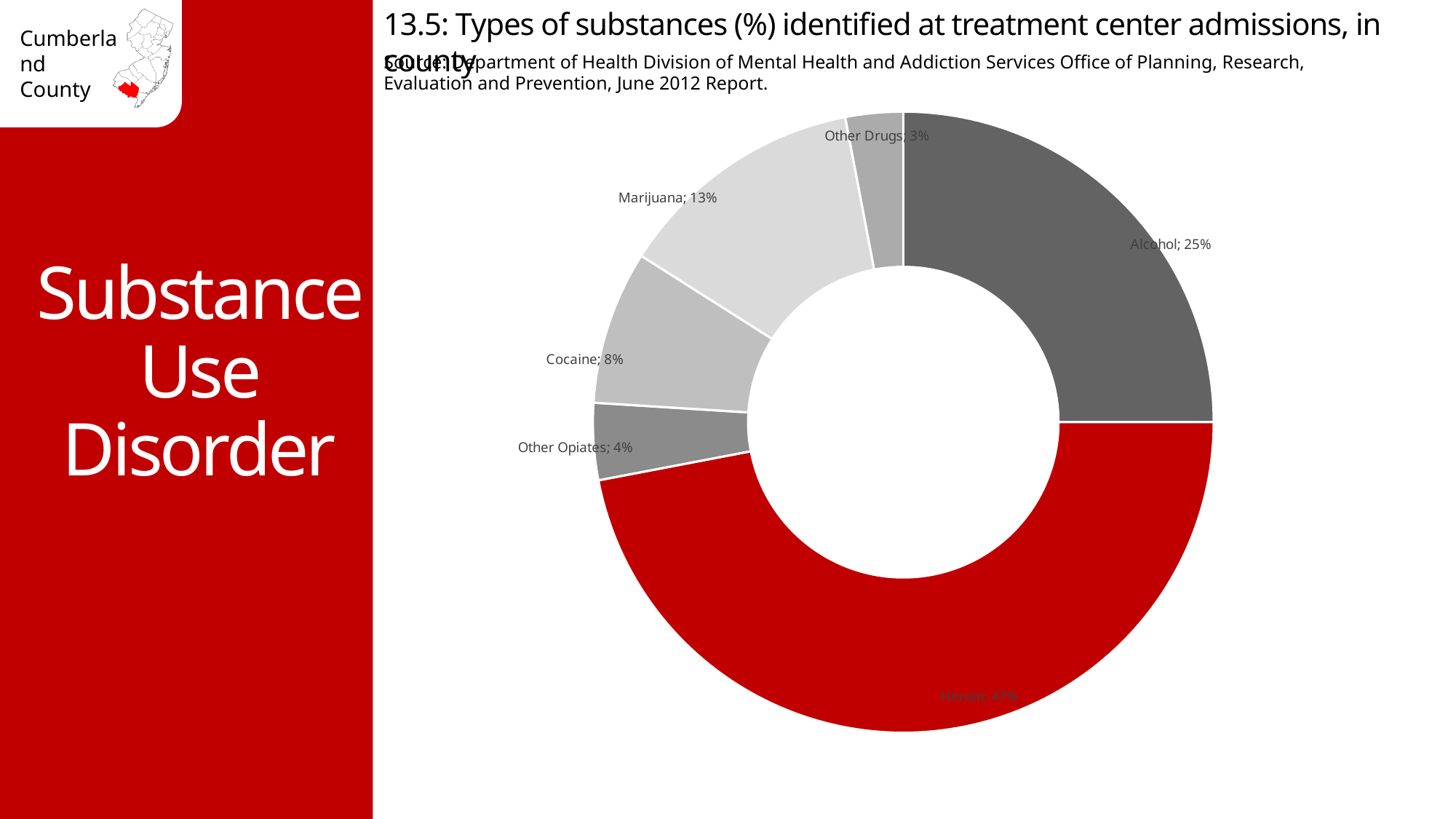
Which substance has the largest share of treatment center admissions? Heroin What percentage of treatment center admissions is identified as Heroin? 47% What percentage is shown for Other Opiates? 4% How many substance categories are shown in the chart? 6 What percentage of treatment center admissions is identified as Alcohol? 25% What colour is the Heroin segment of the chart? Red What percentage is shown for Marijuana? 13% What is the difference in percentage points between Heroin and Alcohol? 22 Which substance has the smallest share of treatment center admissions? Other Drugs What percentage is shown for Cocaine? 8% Which has a larger share, Marijuana or Cocaine? Marijuana What kind of chart is used to show the types of substances? Doughnut (pie) chart